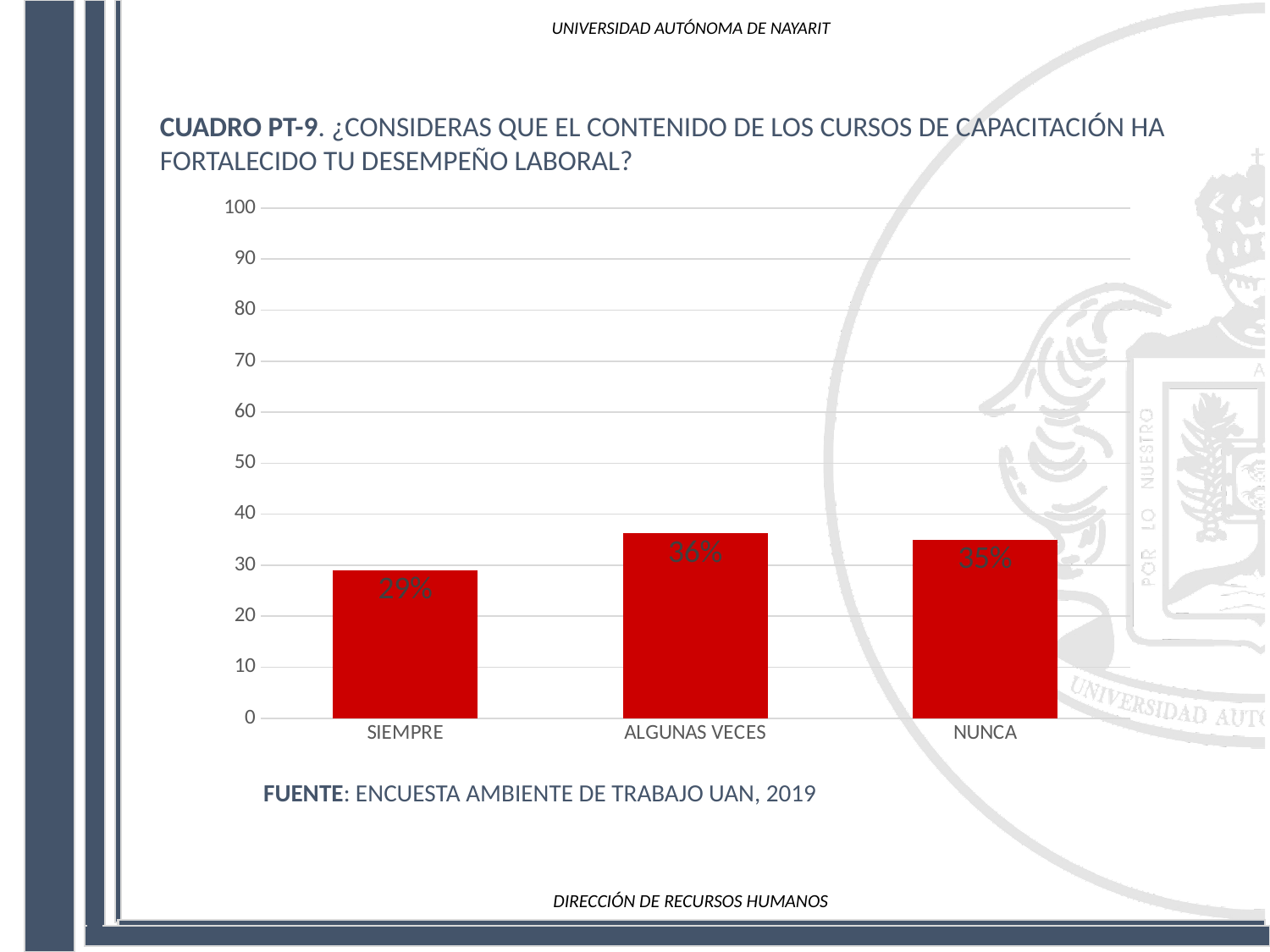
Which is larger, the value for SIEMPRE or the value for NUNCA? NUNCA What is the value for NUNCA? 35% Which category has the highest value? ALGUNAS VECES Is the value for SIEMPRE greater or less than 30? less What source is cited below the chart? ENCUESTA AMBIENTE DE TRABAJO UAN, 2019 What is the difference between the values for ALGUNAS VECES and SIEMPRE? 7% Which category has the lowest value? SIEMPRE How many categories are shown on the x axis? 3 What is the value for SIEMPRE? 29% What kind of chart is shown on the slide? bar chart What is the difference between the values for NUNCA and SIEMPRE? 6% What is the value for ALGUNAS VECES? 36%